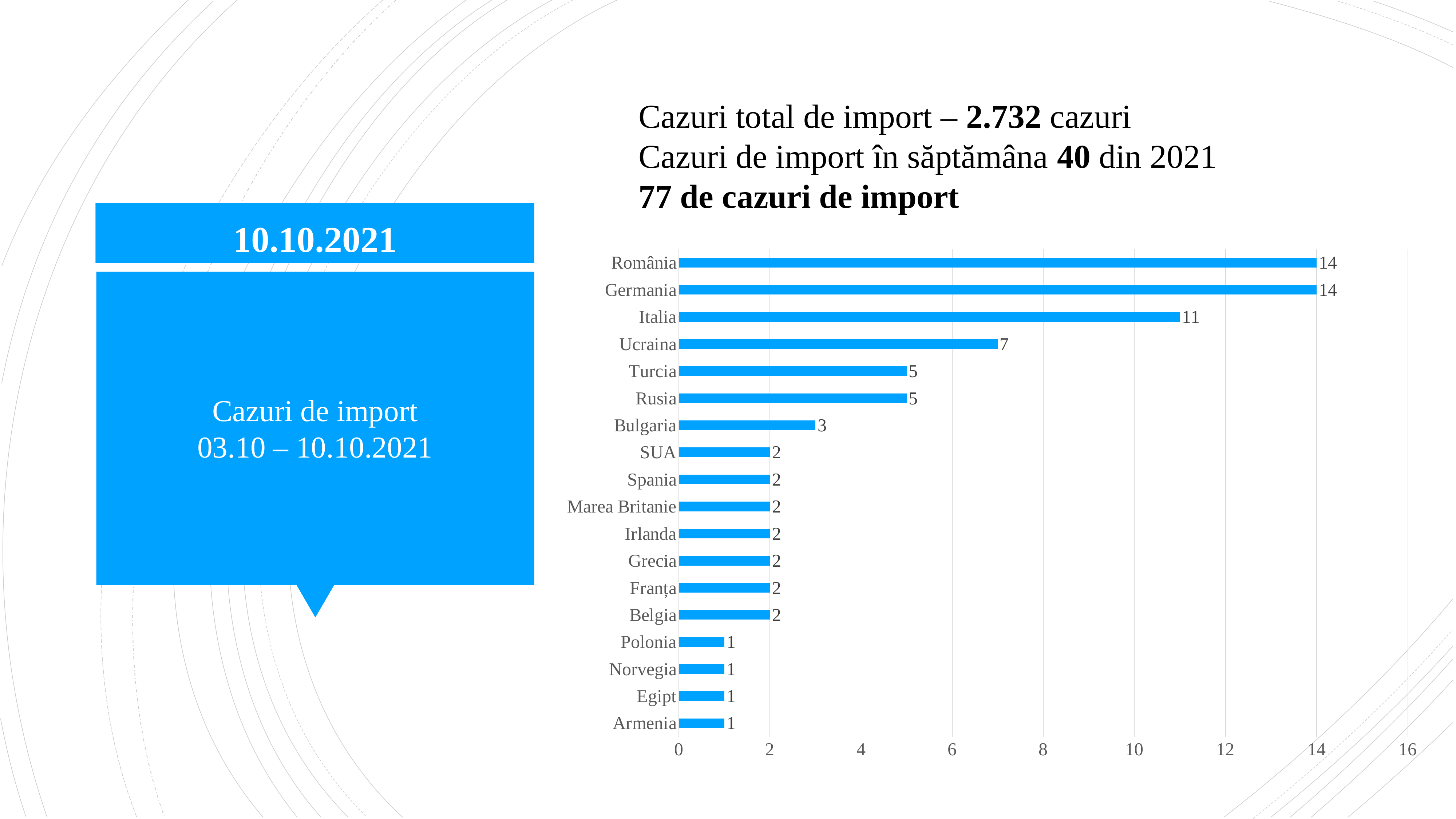
What is the highest value shown on the chart? 14 What is the difference between the values for Italia and Ucraina? 4 What is the difference between the values for România and Bulgaria? 11 What is the value for Polonia? 1 What is the value for Turcia? 5 How many countries are shown on the chart? 18 What kind of chart is shown on the slide? Bar chart What is the value for Ucraina? 7 Is the value for Italia greater or less than 10? greater What is the value for Bulgaria? 3 What is the value for Italia? 11 Which has a larger value, Ucraina or Rusia? Ucraina